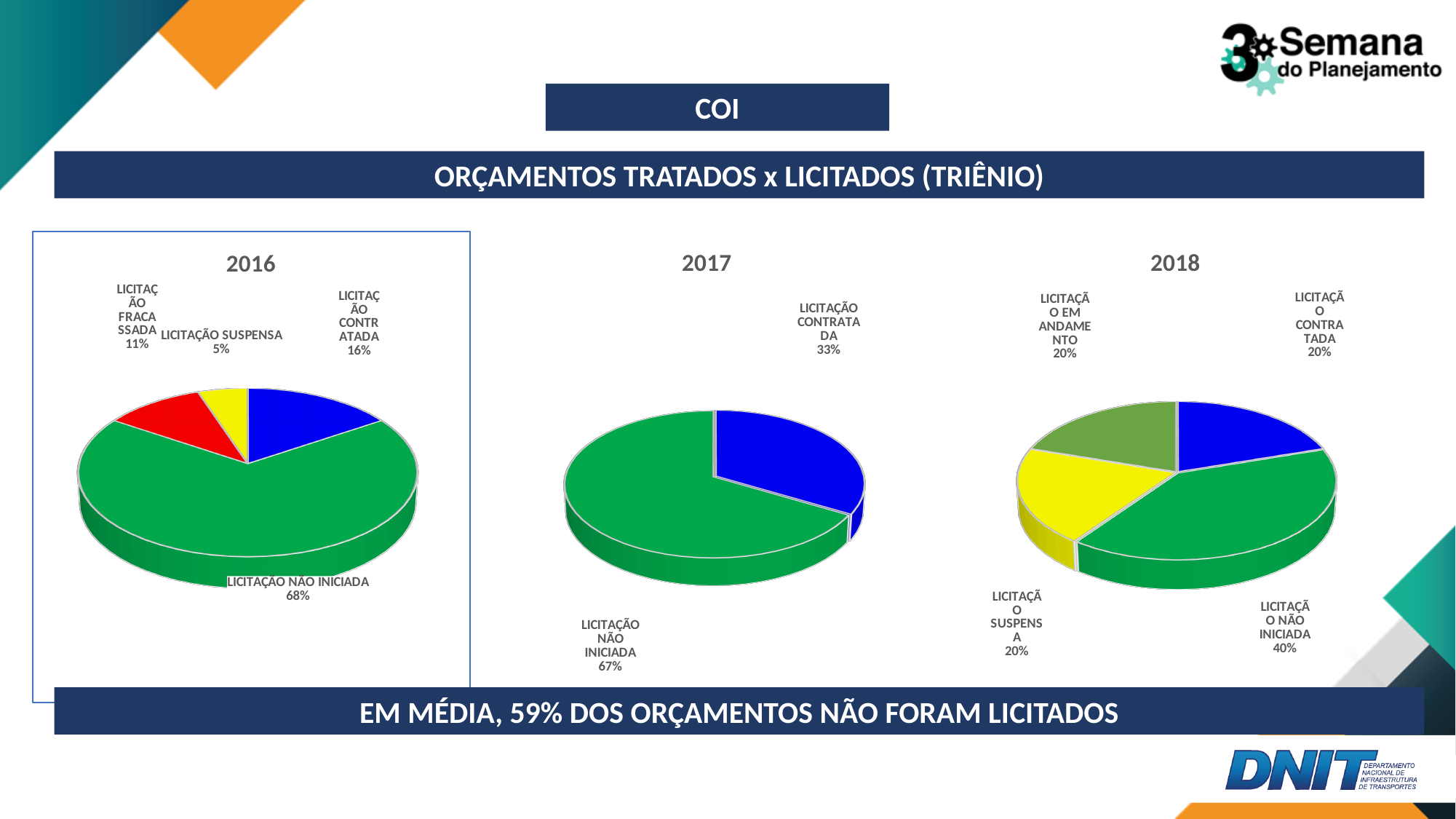
In the 2018 pie chart, what share is labelled for LICITAÇÃO NÃO INICIADA? 40% In the 2016 pie chart, what share is labelled for LICITAÇÃO NÃO INICIADA? 68% In the 2017 pie chart, what share is labelled for LICITAÇÃO CONTRATADA? 33% In the 2016 pie chart, which category has the smallest slice? LICITAÇÃO SUSPENSA Which is larger: the LICITAÇÃO CONTRATADA share in 2017 or in 2018? 2017 In the 2018 pie chart, how many slices are there? 4 In the 2017 pie chart, how many slices are there? 2 What type of chart is used for the 2016, 2017 and 2018 data? Pie chart In the 2018 pie chart, which category has the largest slice? LICITAÇÃO NÃO INICIADA In the 2016 pie chart, how many slices are there? 4 In the 2017 pie chart, what is the difference in percentage points between LICITAÇÃO NÃO INICIADA and LICITAÇÃO CONTRATADA? 34